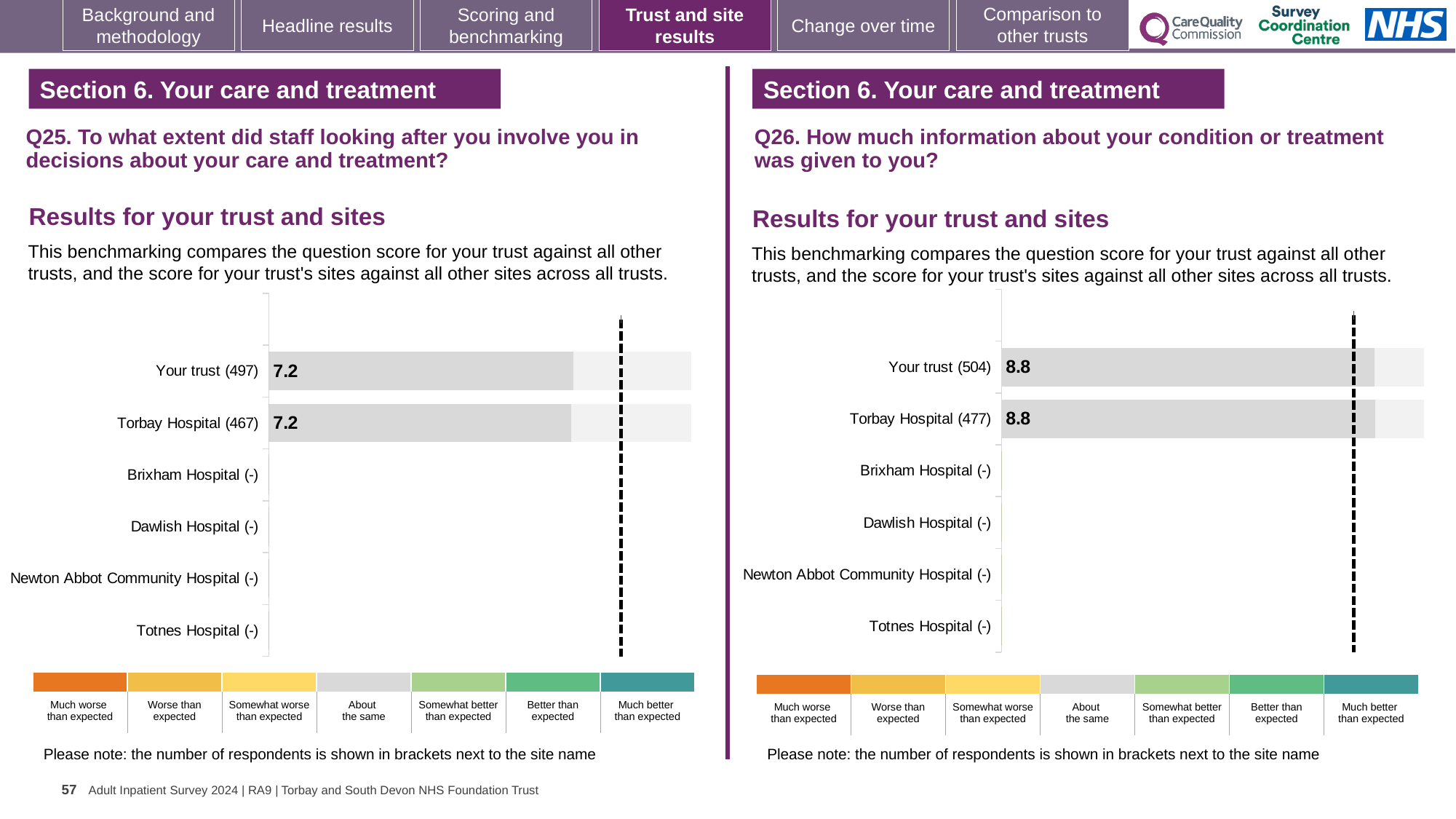
In the Q26 chart on the right, what is the score for Your trust (504)? 8.8 How many site/trust categories are listed on the y axis of the Q25 chart on the left? 6 In the Q25 chart on the left, what is the difference between the scores for Your trust and Torbay Hospital? 0 In the Q26 chart on the right, how many respondents are shown in brackets for Your trust? 504 Which is larger: the Your trust score in the Q25 chart on the left or the Your trust score in the Q26 chart on the right? Q26 chart (8.8) In the Q25 chart on the left, how many respondents are shown in brackets for Torbay Hospital? 467 In the Q26 chart on the right, what is the score for Torbay Hospital (477)? 8.8 How many site/trust categories are listed on the y axis of the Q26 chart on the right? 6 In the Q25 chart on the left, what is the score for Torbay Hospital (467)? 7.2 What kind of chart is used for the Q25 results on the left? Bar chart In the Q26 chart on the right, what is the difference between the scores for Your trust and Torbay Hospital? 0 In the Q25 chart on the left, what is the score for Your trust (497)? 7.2